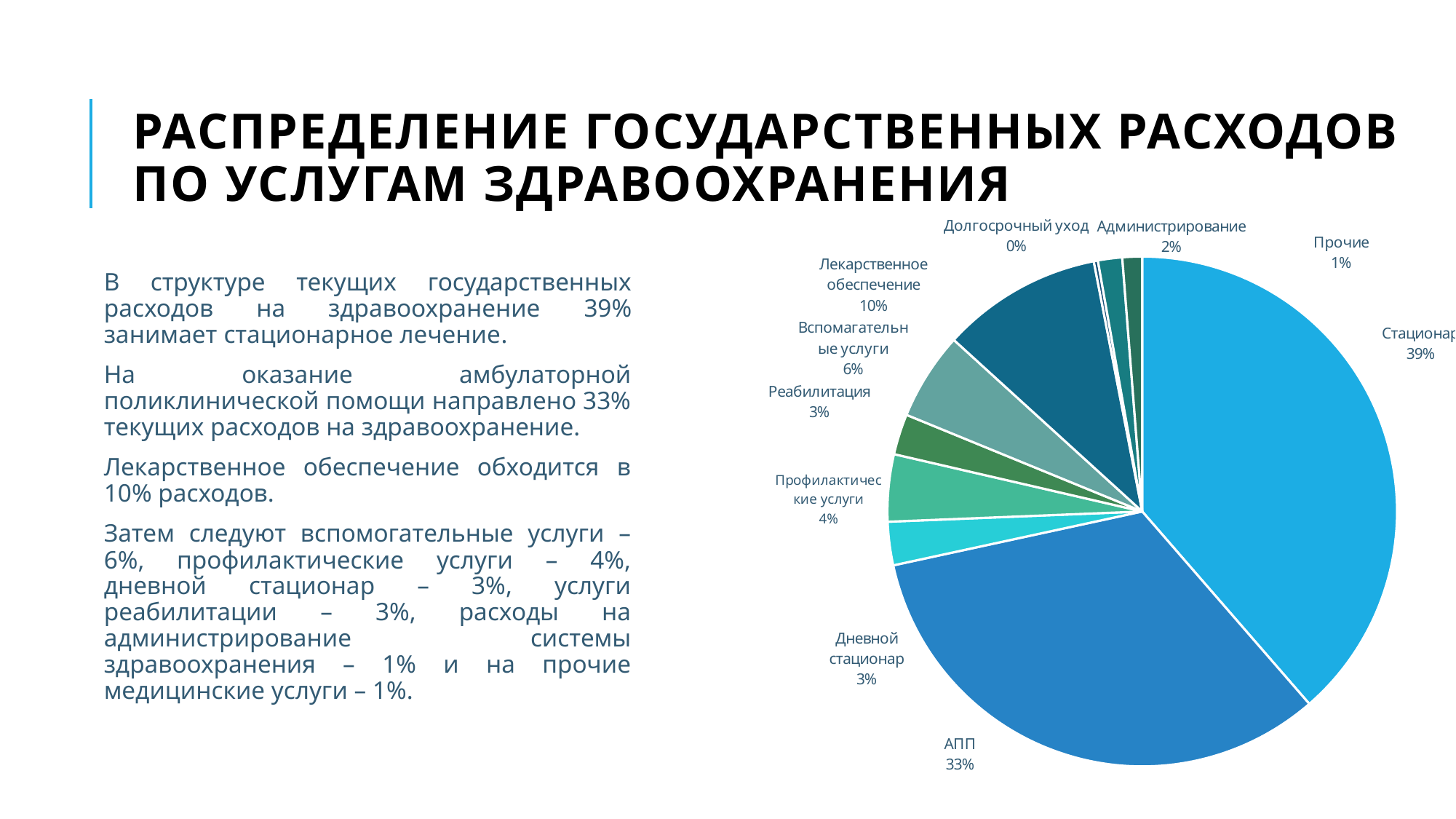
What share of the pie does Стационар have? 39% What share of the pie does АПП have? 33% Which is larger, the share for Профилактические услуги or the share for Реабилитация? Профилактические услуги Which category has the smallest slice of the pie? Долгосрочный уход What is the value shown for Лекарственное обеспечение? 10% How many categories are shown in the pie chart? 10 What is the value shown for Прочие? 1% What is the value shown for Вспомогательные услуги? 6% What kind of chart is shown on the slide? Pie chart Which category has the largest slice of the pie? Стационар What is the value shown for Администрирование? 2% What is the difference between the shares of Стационар and АПП? 6%